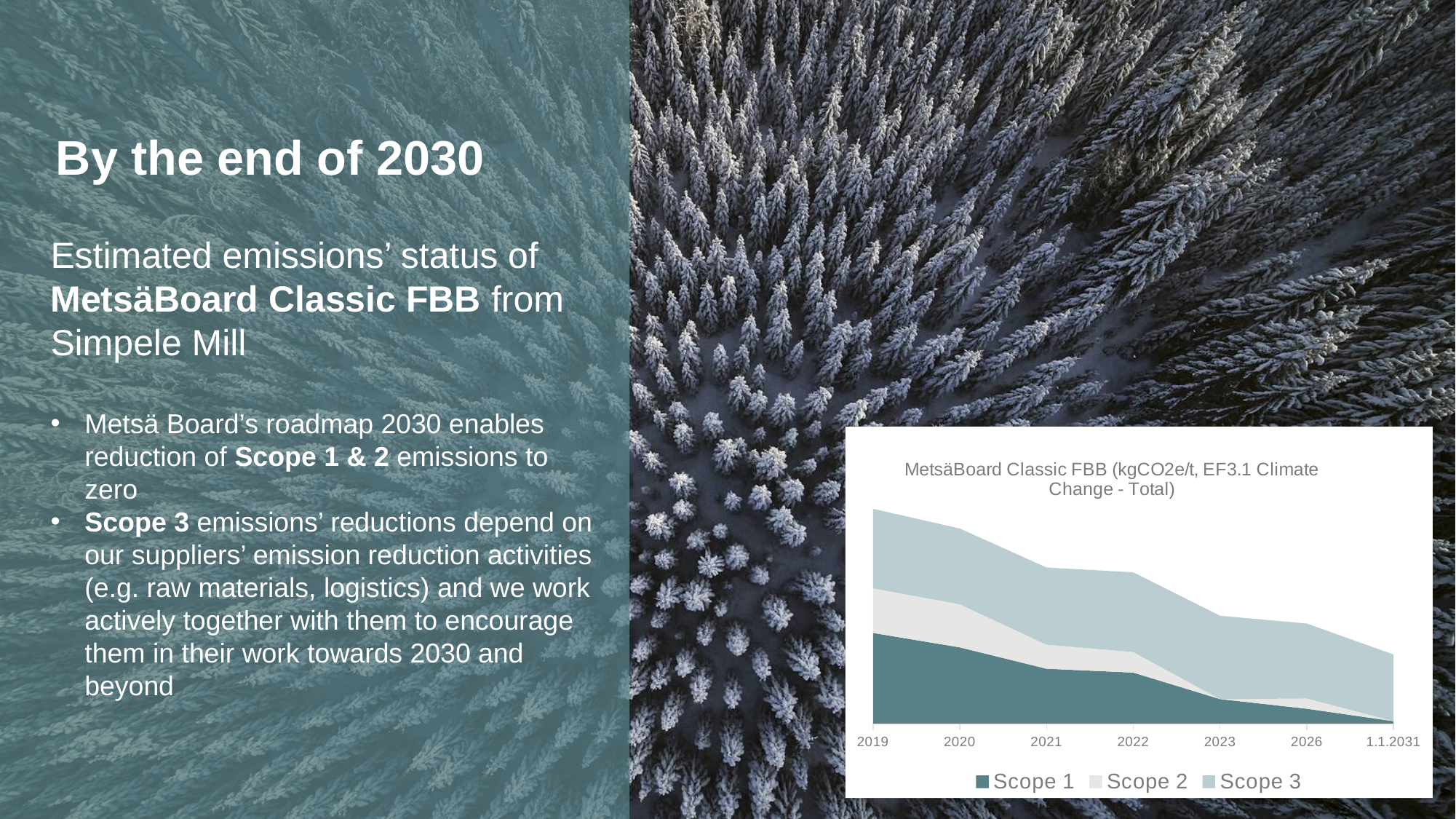
What is the last label on the x axis of the chart? 1.1.2031 Do the total emissions in the chart rise or fall from 2019 to 1.1.2031? Fall What is the title of the chart? MetsäBoard Classic FBB (kgCO2e/t, EF3.1 Climate Change - Total) Does the Scope 2 area rise or fall along the x axis of the chart? Fall How many time points are shown on the x axis of the chart? 7 Which series are listed in the chart's legend? Scope 1, Scope 2, Scope 3 In which year is the total stacked value highest in the chart? 2019 Which series has the largest value at 1.1.2031 in the chart? Scope 3 How many series does the chart's legend list? 3 Is the Scope 1 value larger in 2019 or at 1.1.2031? 2019 At which x-axis point is the total stacked value lowest in the chart? 1.1.2031 What kind of chart is shown on the slide? Stacked area chart